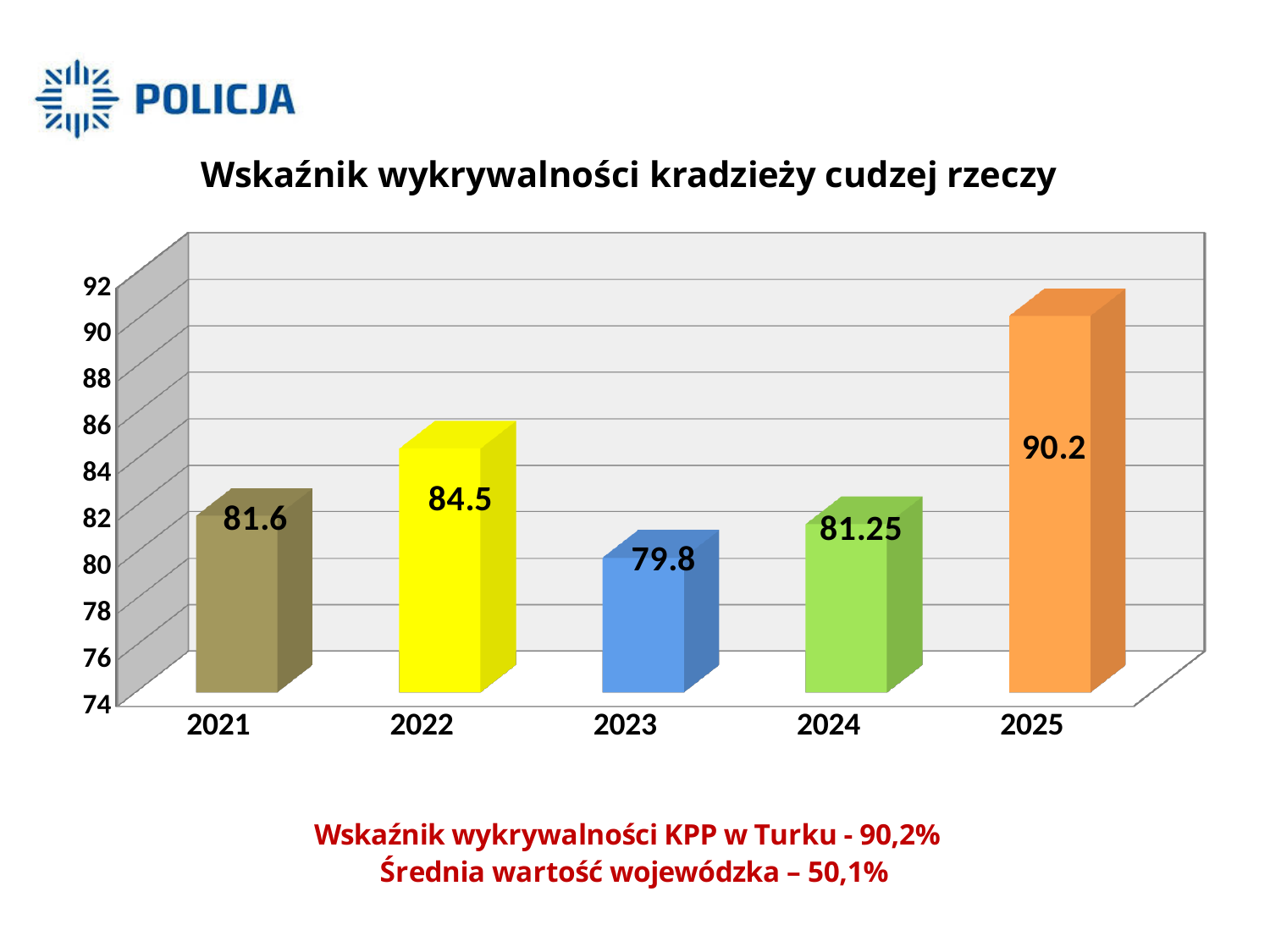
What is the value for 2025? 90.2 What kind of chart is shown on the slide? bar chart What is the title of the chart? Wskaźnik wykrywalności kradzieży cudzej rzeczy What is the difference between the values for 2022 and 2021? 2.9 Is the value for 2024 greater or less than 80? greater What is the value for 2021? 81.6 Which year has the highest value? 2025 Which is larger, the value for 2022 or the value for 2024? 2022 Which year has the lowest value? 2023 What is the difference between the values for 2025 and 2023? 10.4 What is the value for 2023? 79.8 How many years are shown on the x axis? 5